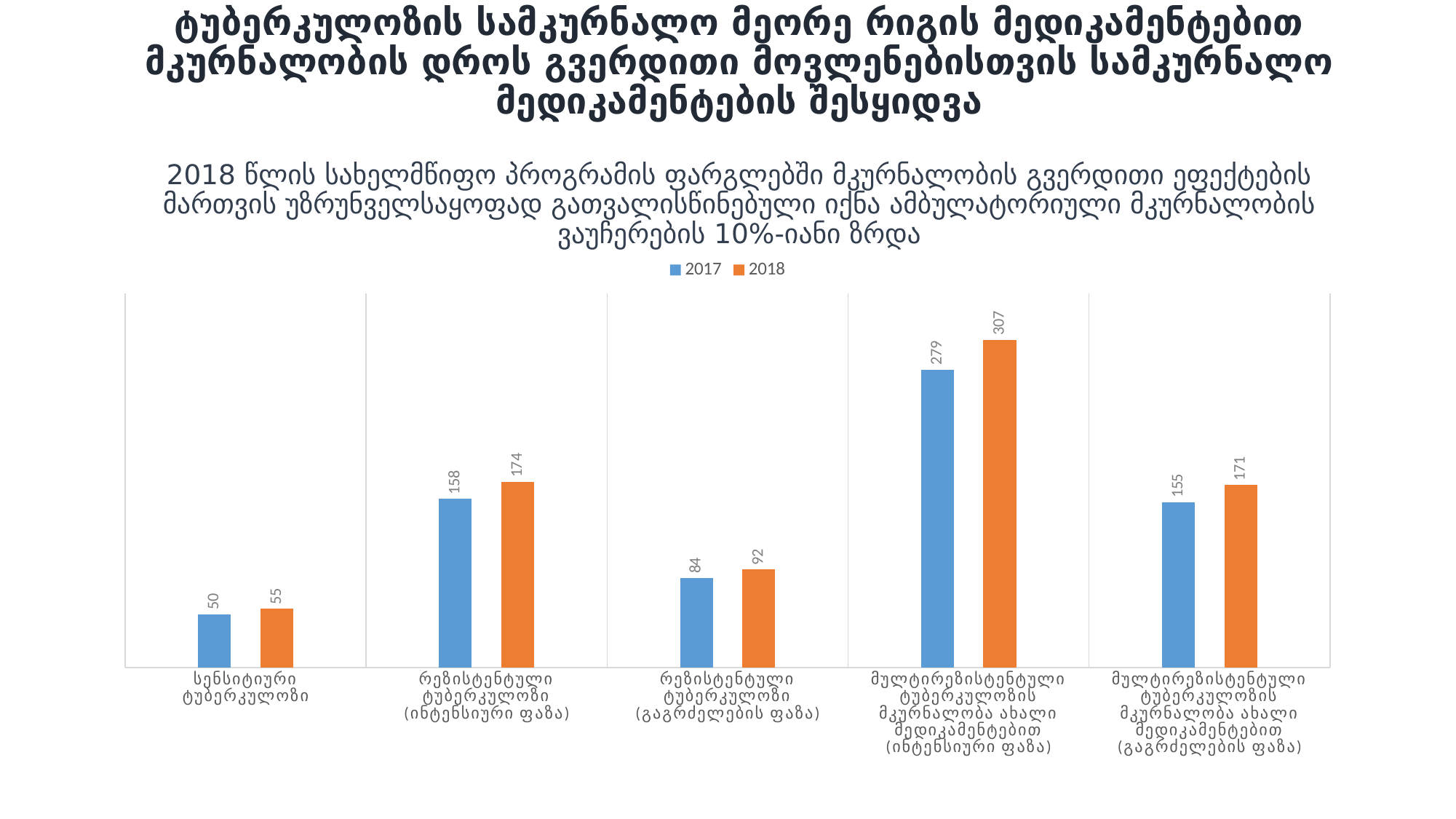
How many categories are shown on the x axis? 5 Which is larger: the 2017 value for რეზისტენტული ტუბერკულოზი (ინტენსიური ფაზა) or the 2018 value for მულტირეზისტენტული ტუბერკულოზის მკურნალობა ახალი მედიკამენტებით (გაგრძელების ფაზა)? 2018 value for მულტირეზისტენტული ტუბერკულოზის მკურნალობა ახალი მედიკამენტებით (გაგრძელების ფაზა) What is the 2018 value for რეზისტენტული ტუბერკულოზი (ინტენსიური ფაზა)? 174 Which category has the lowest 2017 value? სენსიტიური ტუბერკულოზი What is the difference between the 2018 and 2017 values for მულტირეზისტენტული ტუბერკულოზის მკურნალობა ახალი მედიკამენტებით (ინტენსიური ფაზა)? 28 What kind of chart is shown on the slide? Bar chart What is the 2018 value for მულტირეზისტენტული ტუბერკულოზის მკურნალობა ახალი მედიკამენტებით (გაგრძელების ფაზა)? 171 What is the 2017 value for სენსიტიური ტუბერკულოზი? 50 Which series is shown in orange? 2018 Which category has the highest 2018 value? მულტირეზისტენტული ტუბერკულოზის მკურნალობა ახალი მედიკამენტებით (ინტენსიური ფაზა) What is the 2017 value for რეზისტენტული ტუბერკულოზი (გაგრძელების ფაზა)? 84 How many series does the legend list? 2